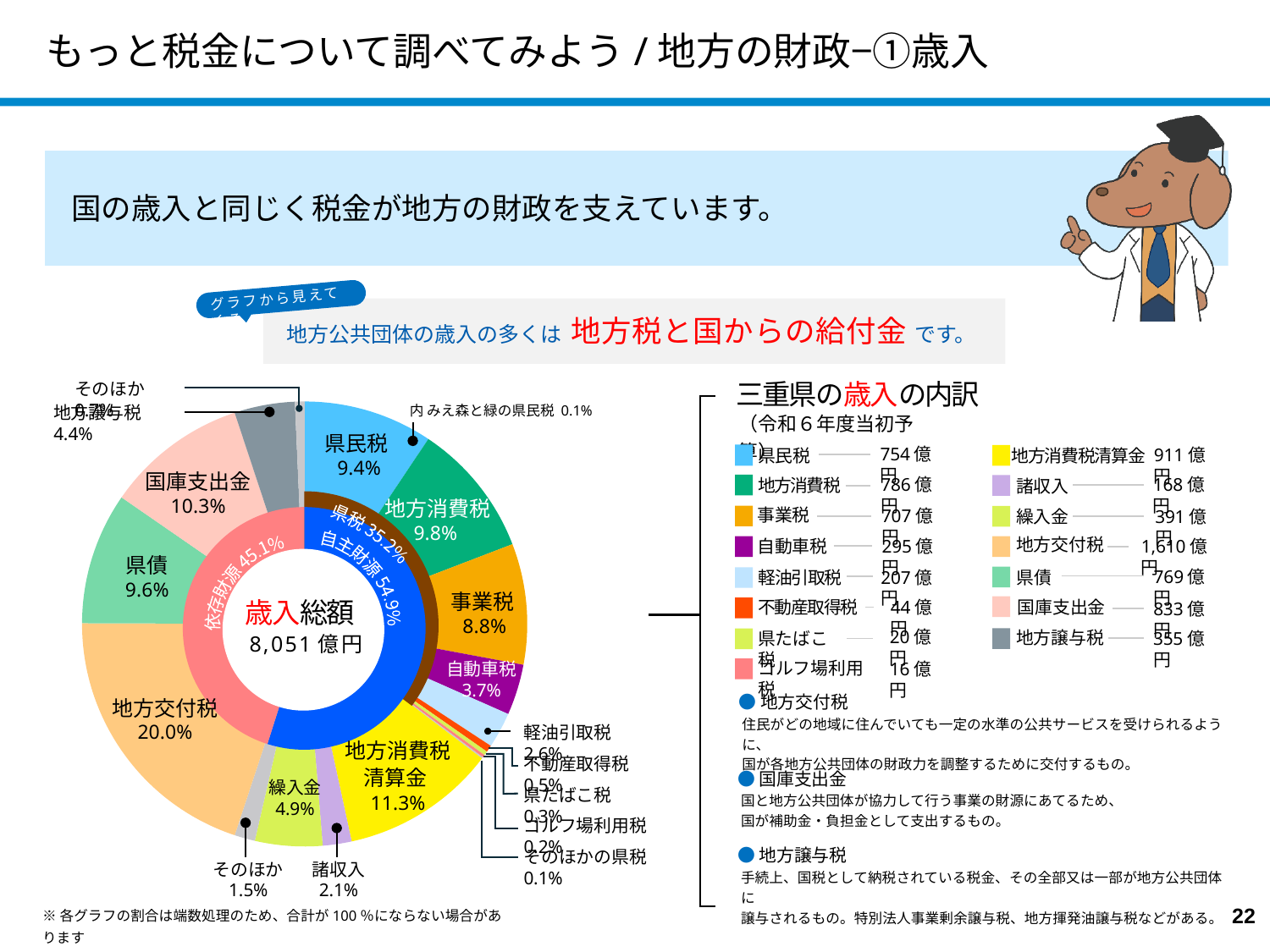
What percentage of revenue does 自主財源 account for according to the inner ring? 54.9% What percentage of revenue does 県税 account for according to the inner ring? 35.2% What is the difference in percentage points between 地方消費税 (9.8%) and 県民税 (9.4%)? 0.4 percentage points What is the amount listed for 地方交付税 in the legend? 1,610 億円 What is the amount listed for 国庫支出金 in the legend? 833 億円 What kind of chart is used to show the breakdown of Mie Prefecture's revenue (三重県の歳入の内訳)? pie chart Which is larger, the share for 県債 or the share for 国庫支出金? 国庫支出金 What is the amount listed for 地方譲与税 in the legend? 355 億円 Which revenue category has the largest share of the pie? 地方交付税 What percentage of revenue does 地方消費税清算金 account for? 11.3% What is the total revenue (歳入総額) shown in the centre of the chart? 8,051 億円 What percentage of revenue does 地方交付税 account for? 20.0%